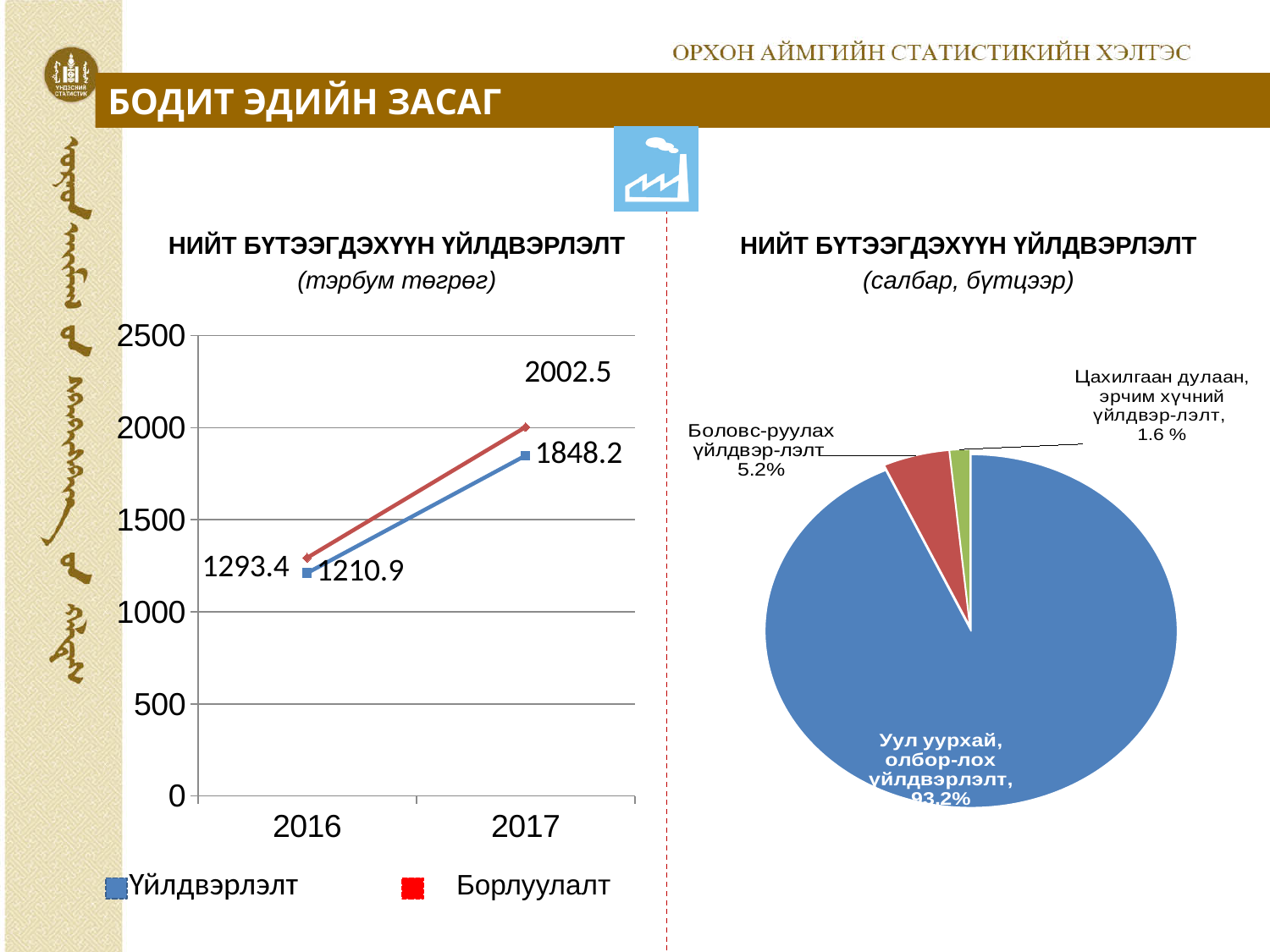
In the right chart (салбар, бүтцээр), which sector has the smallest share? Цахилгаан дулаан, эрчим хүчний үйлдвэр-лэлт In the left chart (тэрбум төгрөг), which series has the higher value in 2016, Үйлдвэрлэлт or Борлуулалт? Борлуулалт In the left chart (тэрбум төгрөг), what is the value of Үйлдвэрлэлт in 2017? 1848.2 How many series does the legend of the left chart (тэрбум төгрөг) list? 2 In the left chart (тэрбум төгрөг), what is the value of Борлуулалт in 2017? 2002.5 How many slices does the right chart (салбар, бүтцээр) have? 3 In the left chart (тэрбум төгрөг), what is the difference between Борлуулалт and Үйлдвэрлэлт in 2017? 154.3 What kind of chart is the left chart (тэрбум төгрөг)? line chart In the left chart (тэрбум төгрөг), what is the value of Борлуулалт in 2016? 1293.4 In the left chart (тэрбум төгрөг), does Үйлдвэрлэлт rise or fall from 2016 to 2017? rise In the right chart (салбар, бүтцээр), what share does Уул уурхай, олбор-лох үйлдвэрлэлт have? 93.2% In the left chart (тэрбум төгрөг), what is the value of Үйлдвэрлэлт in 2016? 1210.9